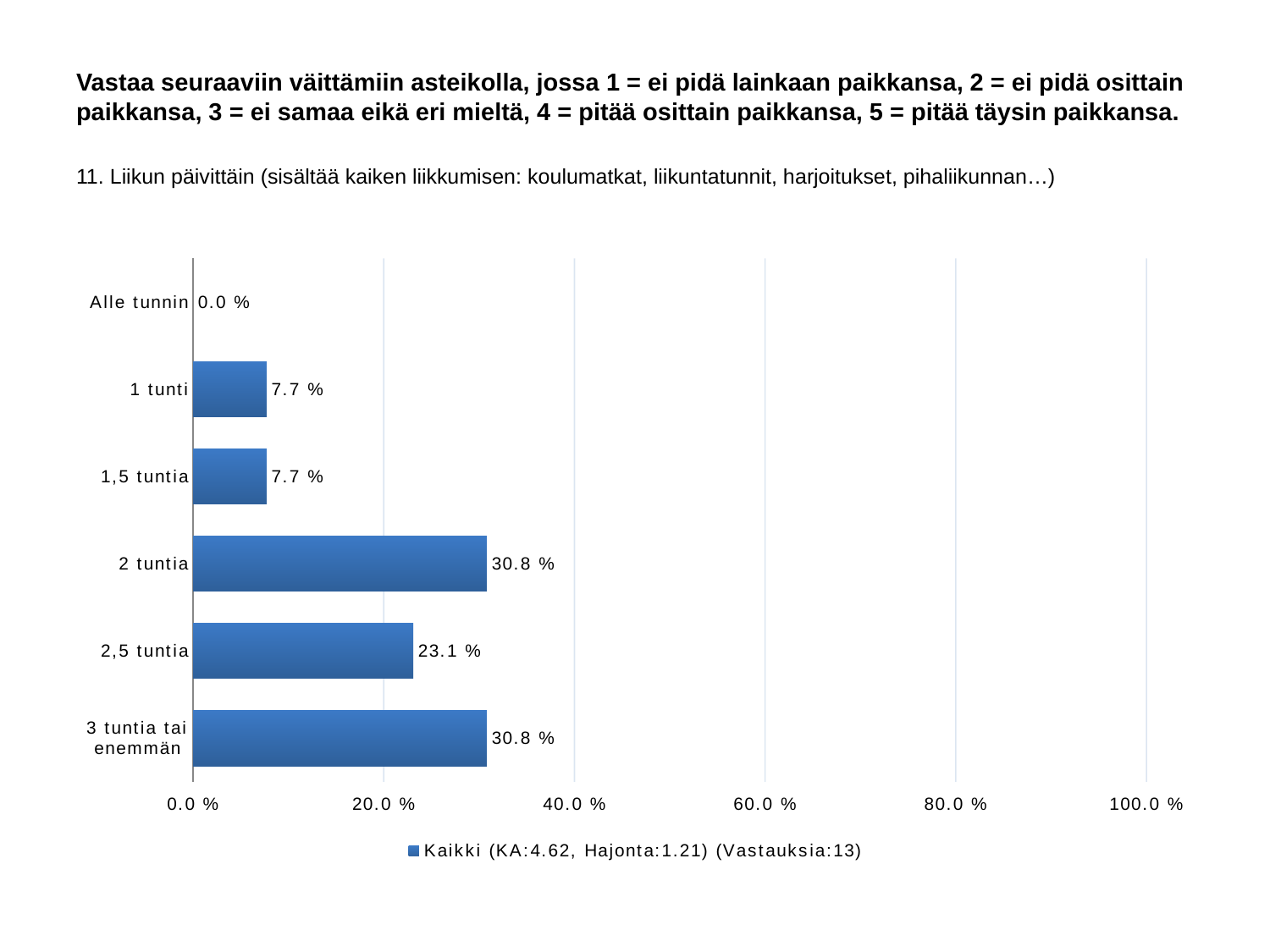
What is the value for "2,5 tuntia"? 23.1 % What kind of chart is shown on the slide? bar chart What is the value for "Alle tunnin"? 0.0 % What is the difference between the values for "2 tuntia" and "2,5 tuntia"? 7.7 % What is the difference between the values for "2,5 tuntia" and "1,5 tuntia"? 15.4 % How many categories are shown on the chart? 6 Which is larger, the value for "2,5 tuntia" or the value for "1 tunti"? 2,5 tuntia Which category has the lowest value? Alle tunnin Is the value for "3 tuntia tai enemmän" greater or less than 40.0 %? less What is the value for "1 tunti"? 7.7 % How many responses (Vastauksia) does the legend report? 13 What is the value for "2 tuntia"? 30.8 %